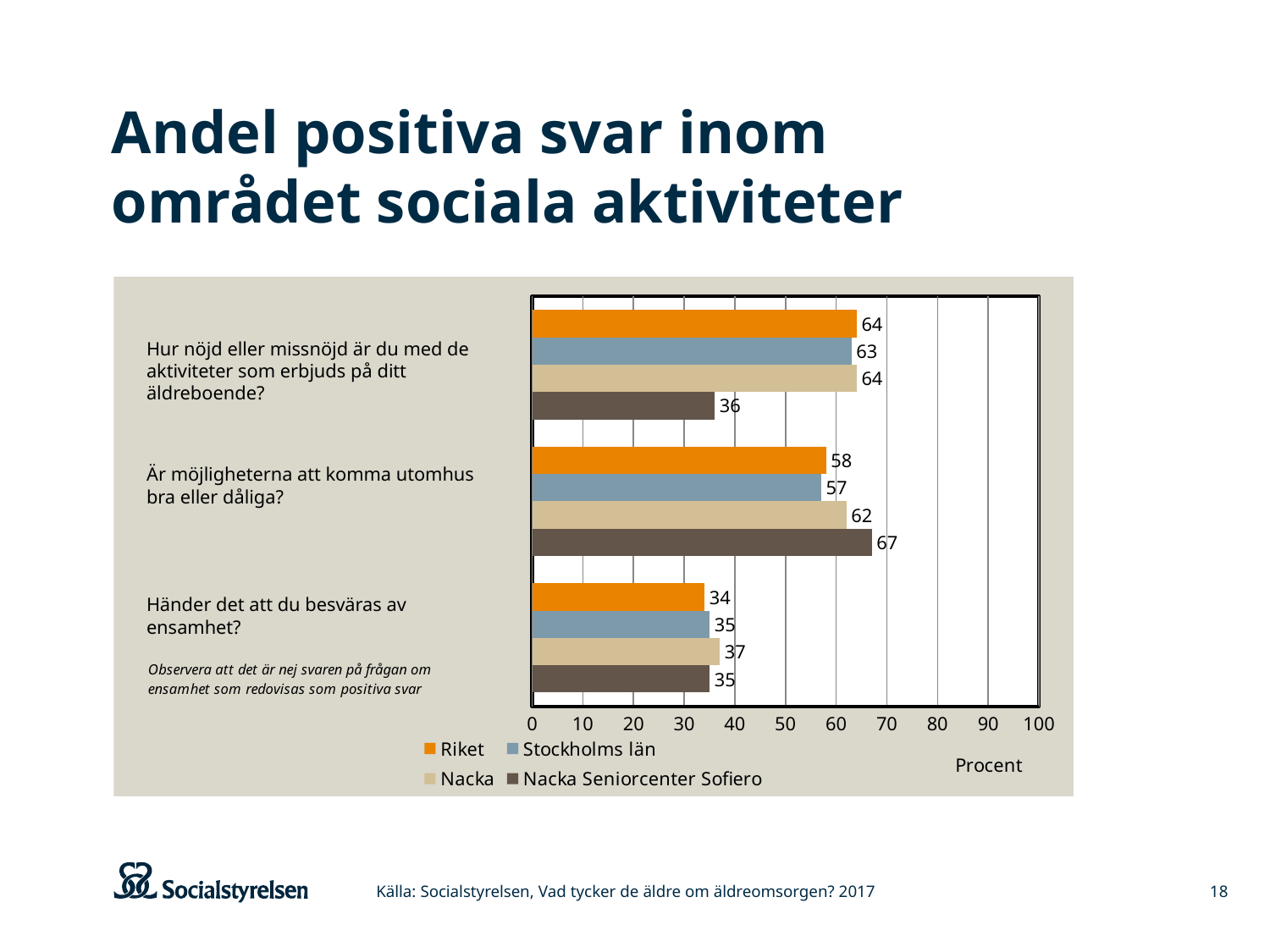
What is the label of the horizontal axis? Procent What is the value for Nacka on the question "Händer det att du besväras av ensamhet?"? 37 What is the value for Nacka Seniorcenter Sofiero on the question "Hur nöjd eller missnöjd är du med de aktiviteter som erbjuds på ditt äldreboende?"? 36 On the question "Är möjligheterna att komma utomhus bra eller dåliga?", which is larger: the value for Nacka or the value for Stockholms län? Nacka What kind of chart is shown on the slide? Bar chart What is the difference between the Nacka Seniorcenter Sofiero value and the Riket value on the question "Är möjligheterna att komma utomhus bra eller dåliga?"? 9 What is the difference between the Riket value and the Nacka Seniorcenter Sofiero value on the question "Hur nöjd eller missnöjd är du med de aktiviteter som erbjuds på ditt äldreboende?"? 28 Which series has the highest value on the question "Är möjligheterna att komma utomhus bra eller dåliga?"? Nacka Seniorcenter Sofiero How many questions (categories) are shown on the chart? 3 How many series does the legend list? 4 What is the value for Riket on the question "Är möjligheterna att komma utomhus bra eller dåliga?"? 58 Which series has the lowest value on the question "Hur nöjd eller missnöjd är du med de aktiviteter som erbjuds på ditt äldreboende?"? Nacka Seniorcenter Sofiero